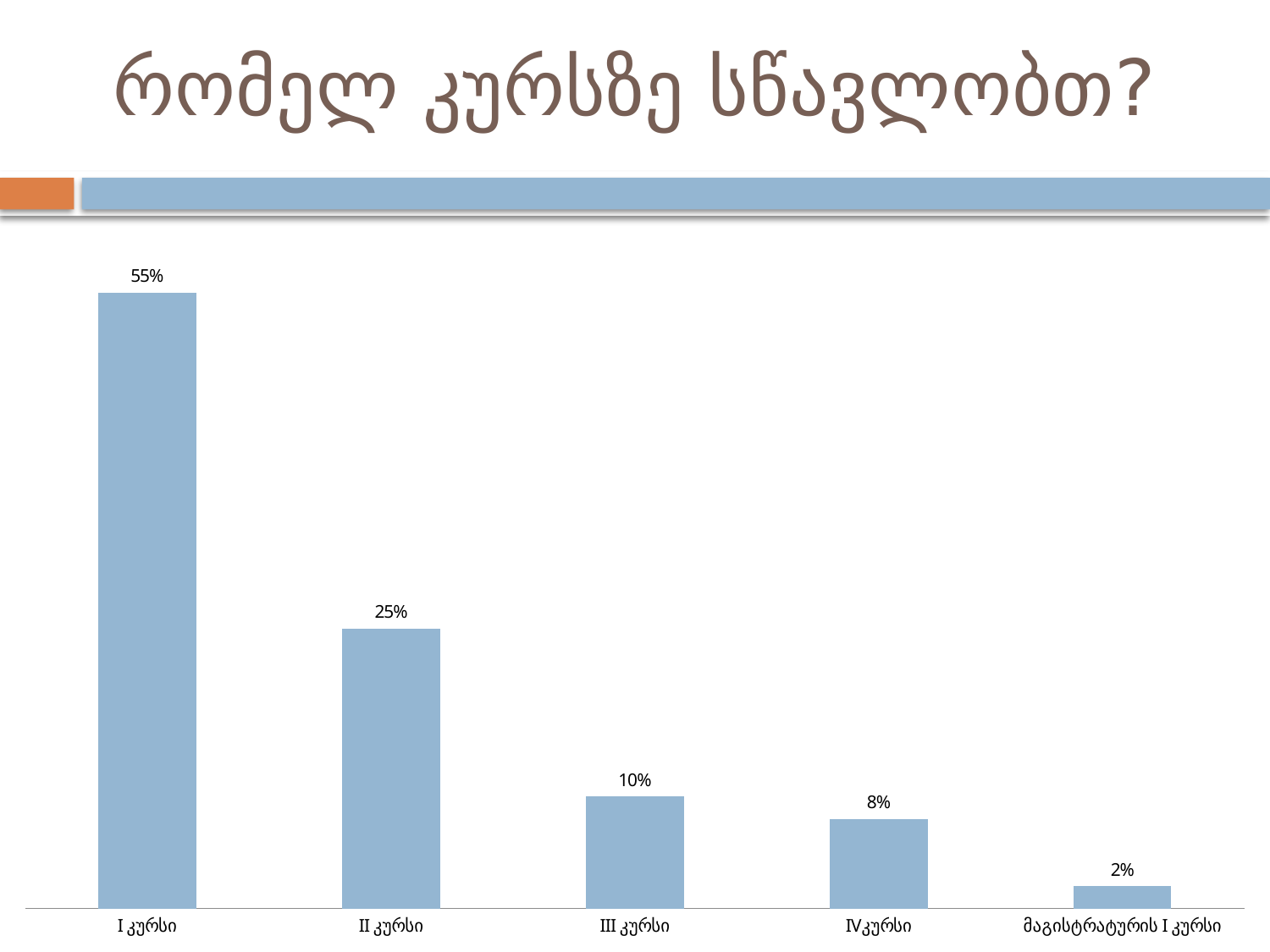
What is the value for IVკურსი? 8% What is the value for მაგისტრატურის I კურსი? 2% What kind of chart is shown on the slide? bar chart Do the values rise or fall from left to right along the x axis? fall How many categories are shown in the chart? 5 What is the value for II კურსი? 25% Which is larger, the value for III კურსი or the value for IVკურსი? III კურსი What is the value for III კურსი? 10% What is the difference between the values for I კურსი and II კურსი? 30% What is the value for I კურსი? 55% Which category has the highest value? I კურსი Which category has the lowest value? მაგისტრატურის I კურსი